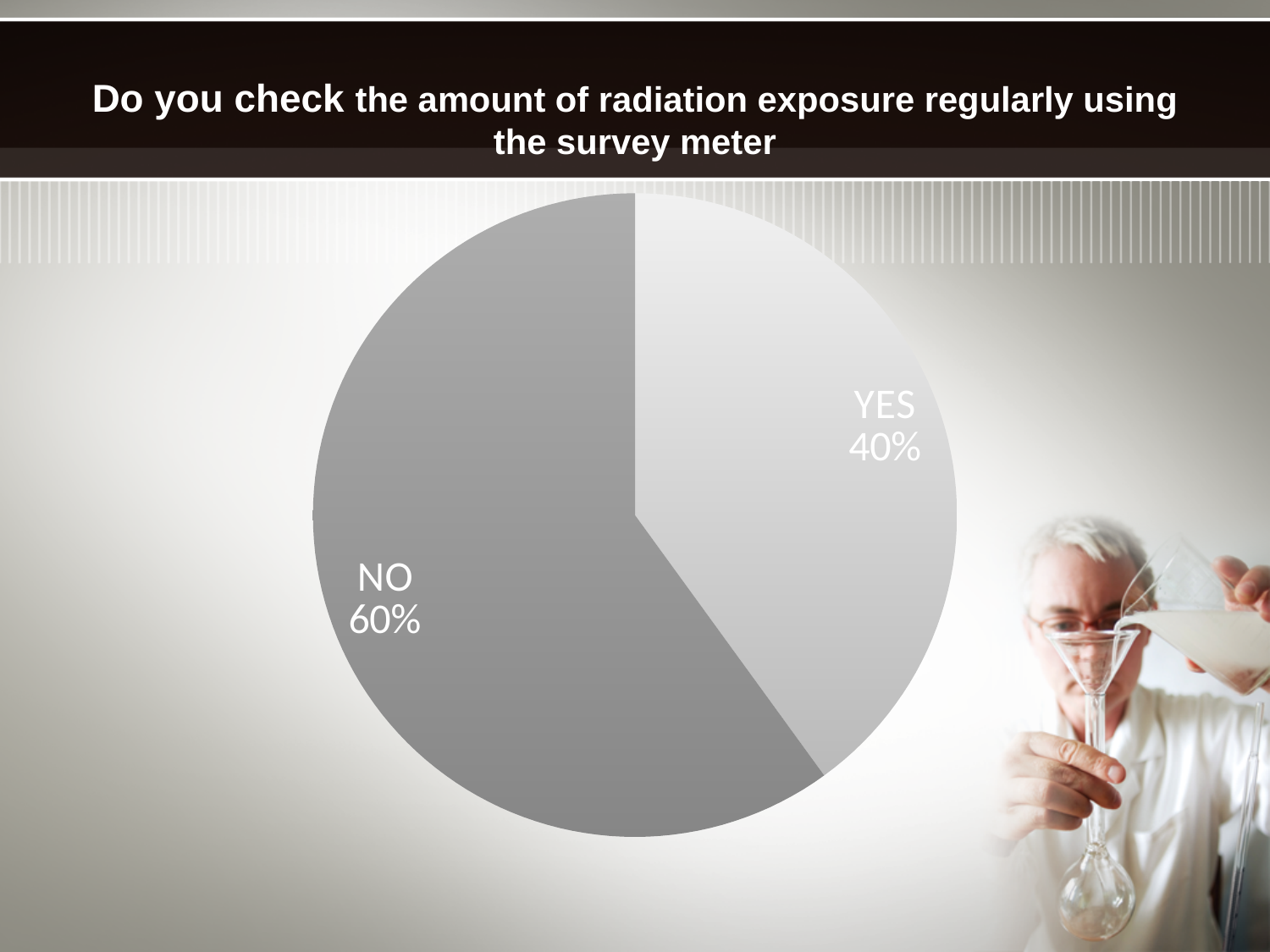
What percentage of respondents answered YES? 40% Which response has the largest share of the pie? NO What share of the pie does the YES slice represent? 40% Which slice is shown in the darker grey colour? NO What percentage of respondents answered NO? 60% How many slices does the pie chart have? 2 What question does the chart title ask? Do you check the amount of radiation exposure regularly using the survey meter What is the difference in percentage points between the NO and YES slices? 20% Which slice is larger, YES or NO? NO Which response has the smallest share of the pie? YES What type of chart is shown on the slide? pie chart